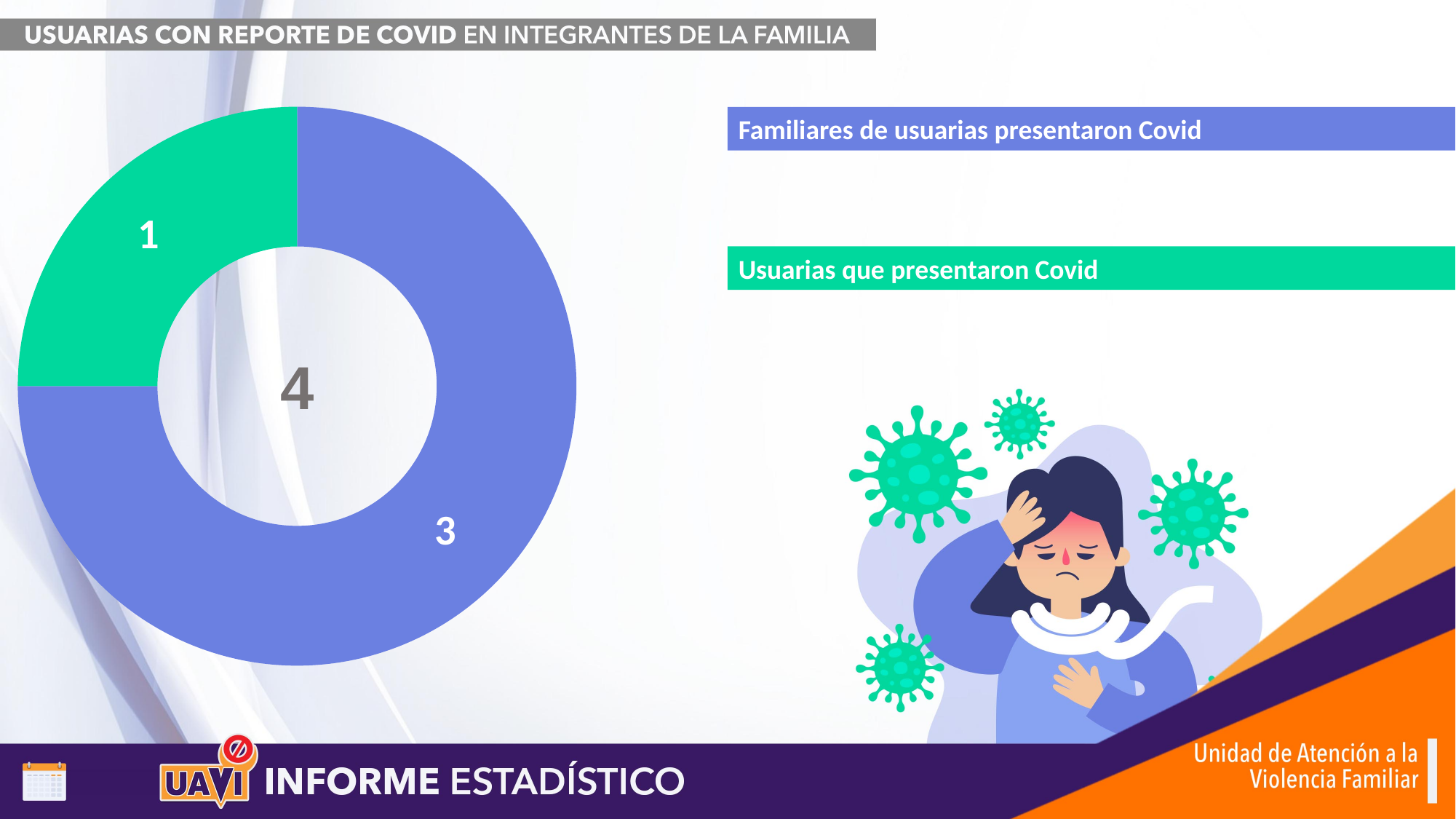
What is the total of all slices in the chart, as shown in the centre of the donut? 4 What colour is the slice for "Usuarias que presentaron Covid"? Green What kind of chart is shown on the slide? Donut (pie) chart What is the difference between the value for "Familiares de usuarias presentaron Covid" and the value for "Usuarias que presentaron Covid"? 2 How many categories does the chart show? 2 Which category has the smallest slice of the chart? Usuarias que presentaron Covid Which category has the largest slice of the chart? Familiares de usuarias presentaron Covid What is the value for "Usuarias que presentaron Covid"? 1 Which is larger: the value for "Familiares de usuarias presentaron Covid" or the value for "Usuarias que presentaron Covid"? Familiares de usuarias presentaron Covid What is the value for "Familiares de usuarias presentaron Covid"? 3 What share of the total does "Familiares de usuarias presentaron Covid" represent? 75% What share of the total does "Usuarias que presentaron Covid" represent? 25%